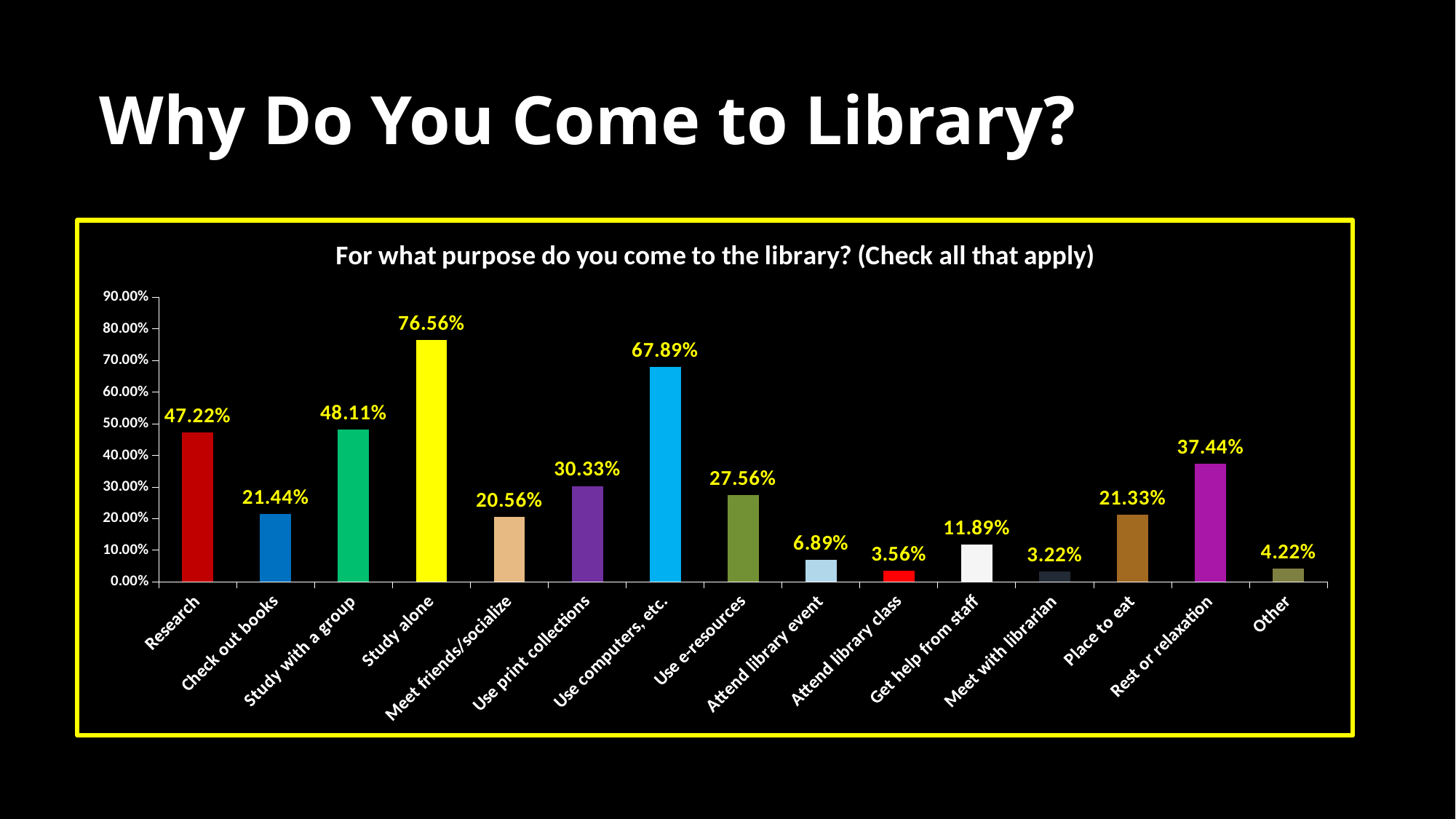
What colour is the bar for Study alone? yellow Which category has the highest value? Study alone Which is larger, Research or Study with a group? Study with a group What is the value for Study alone? 76.56% Is the value for Use print collections greater or less than 40.00%? less How many categories are shown on the x axis? 15 What is the value for Use computers, etc.? 67.89% What is the difference between Study alone and Use computers, etc.? 8.67% Which category has the lowest value? Meet with librarian What is the value for Rest or relaxation? 37.44% What is the title of the chart? For what purpose do you come to the library? (Check all that apply) What kind of chart is this? bar chart